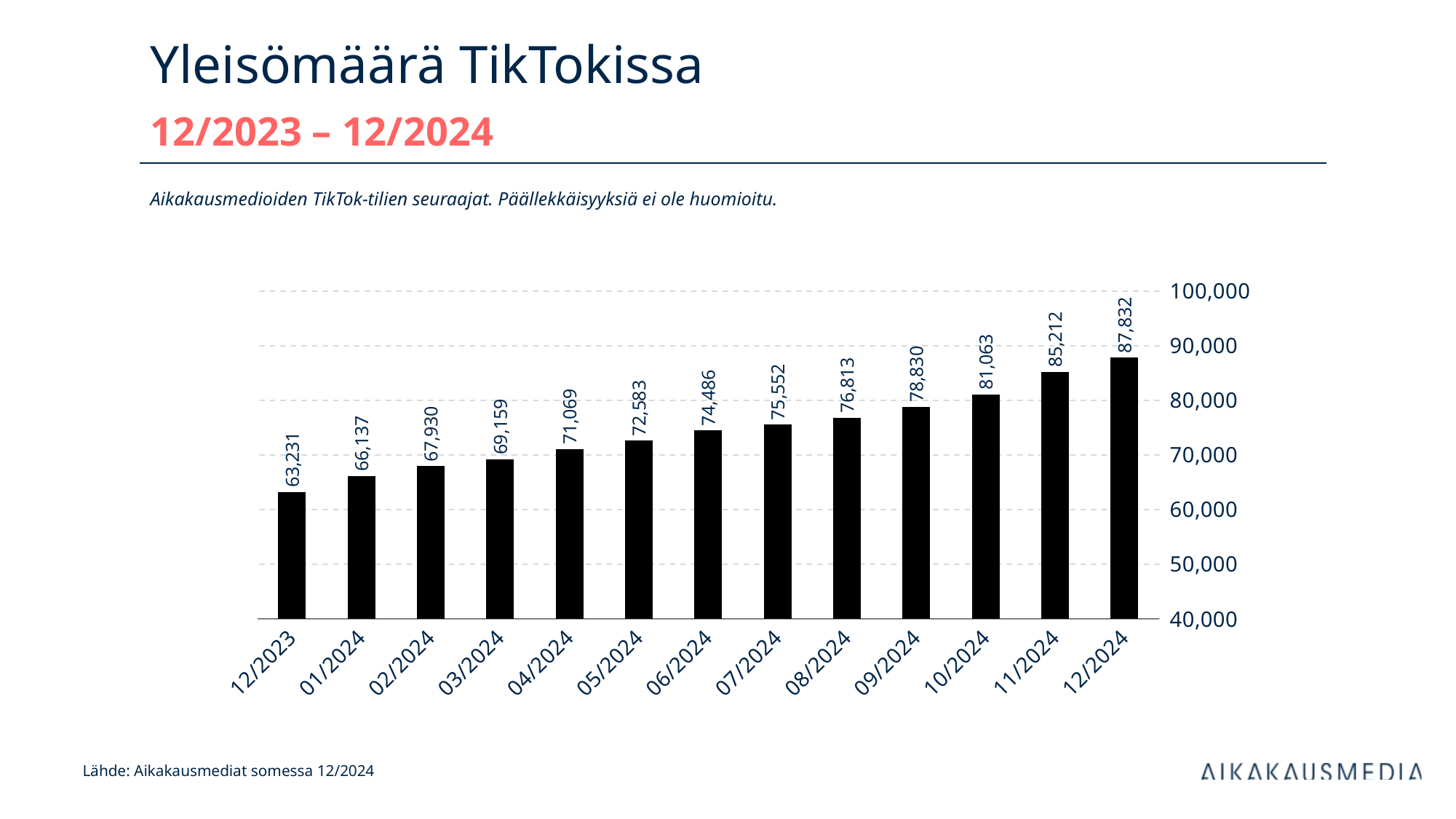
What is the difference between the values for 12/2024 and 12/2023? 24,601 Which is larger, the value for 03/2024 or the value for 09/2024? 09/2024 Which month has the lowest value? 12/2023 Is the value for 10/2024 greater or less than 80,000? greater How many months are shown on the x axis? 13 What kind of chart is shown on the slide? Bar chart What is the value for 06/2024? 74,486 What is the value for 12/2023? 63,231 What is the value for 12/2024? 87,832 Which month has the highest value? 12/2024 What is the difference between the values for 11/2024 and 10/2024? 4,149 Do the values rise or fall from 12/2023 to 12/2024? Rise